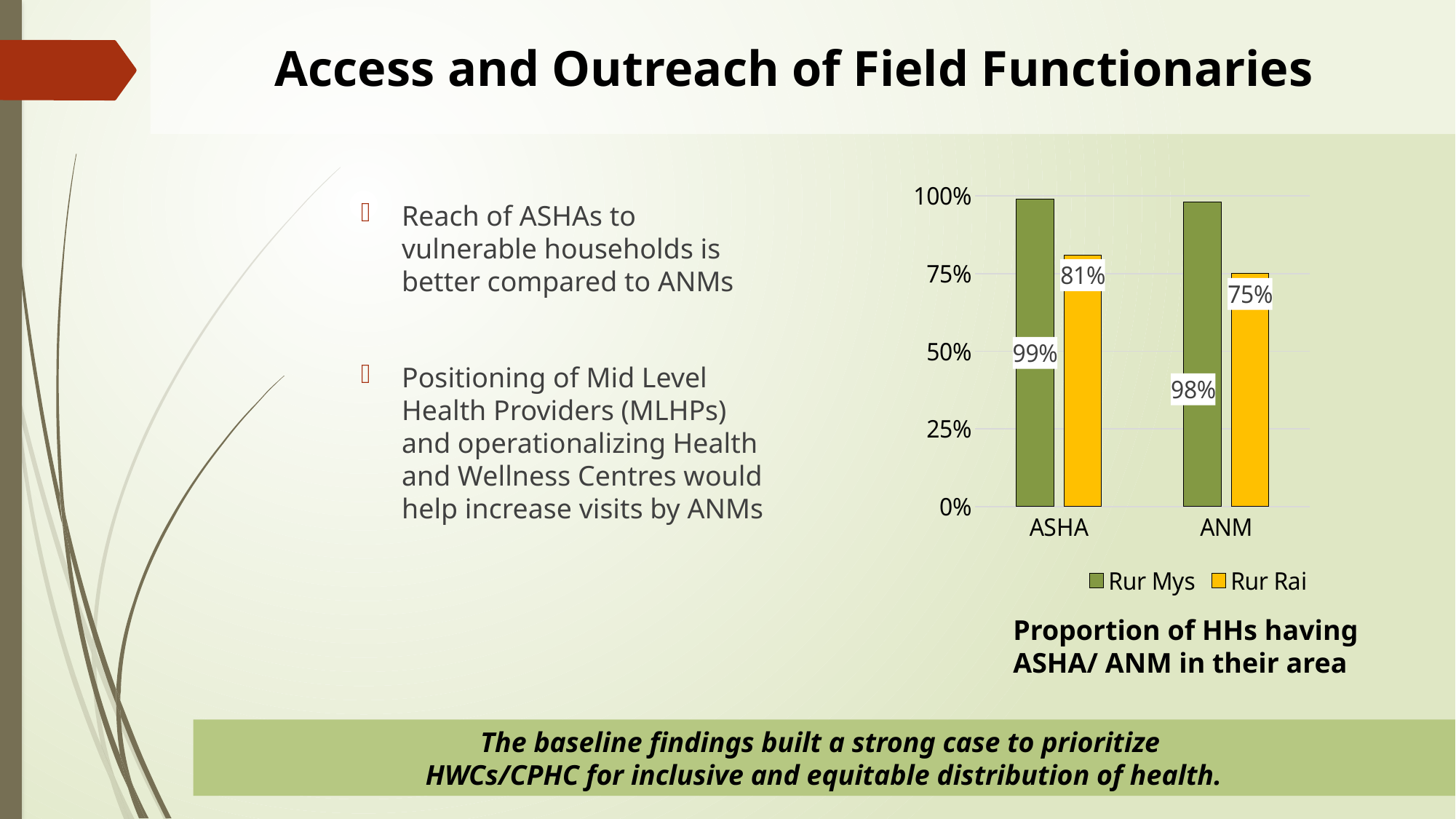
What is the difference between the Rur Rai values for ASHA and ANM? 6% What kind of chart is shown on the slide? Bar chart Which is larger for ANM, Rur Mys or Rur Rai? Rur Mys How many series does the legend list? 2 What is the value for Rur Mys for ANM? 98% What is the value for Rur Mys for ASHA? 99% What is the difference between the Rur Mys and Rur Rai values for ASHA? 18% What is the value for Rur Rai for ANM? 75% Is the Rur Rai value for ANM greater or less than 50%? greater Which category has the lowest Rur Rai value? ANM What is the value for Rur Rai for ASHA? 81% How many categories are shown on the x axis? 2